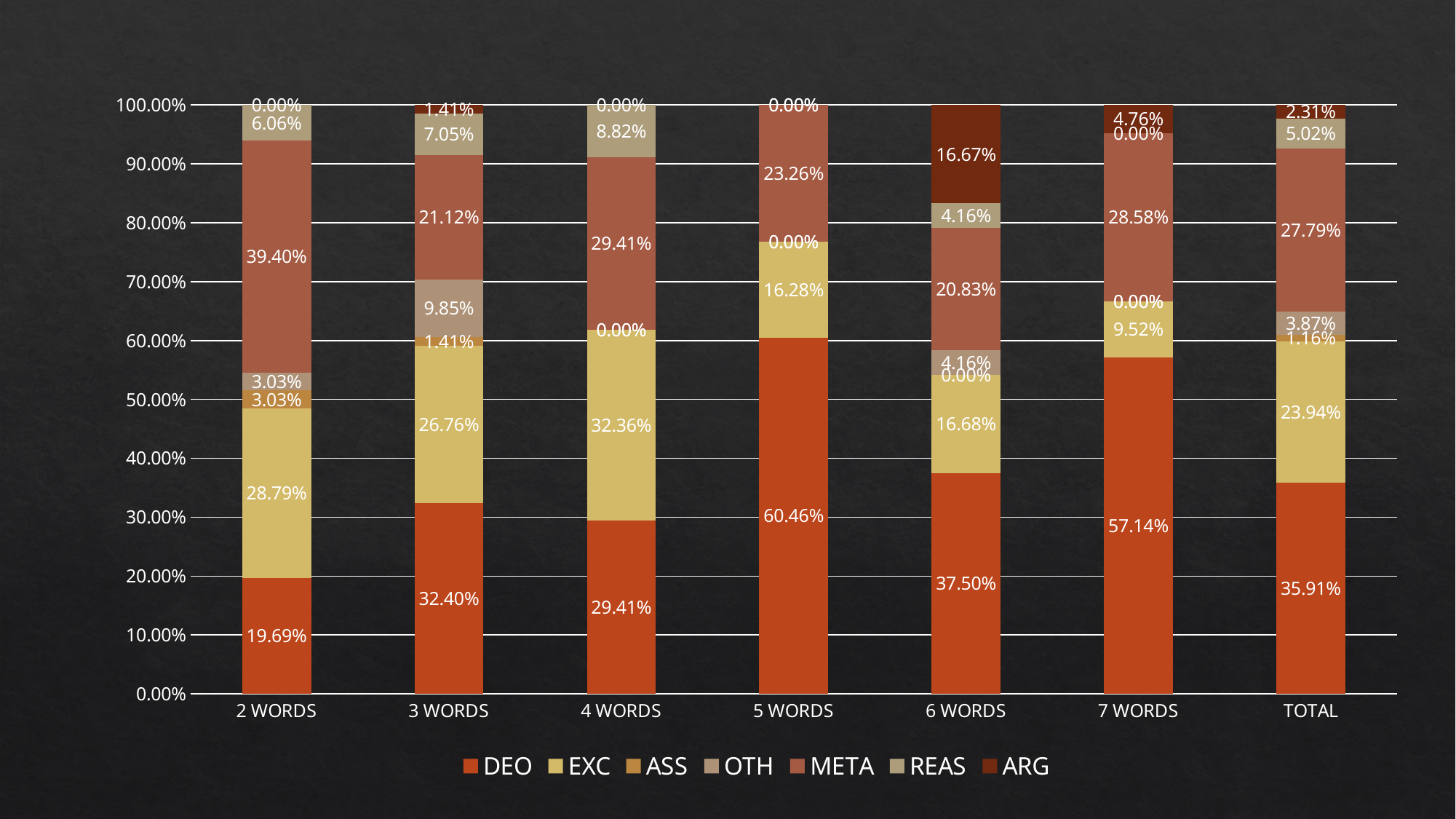
Which has the larger EXC value, 3 WORDS or 4 WORDS? 4 WORDS What is the ARG value for 6 WORDS? 16.67% How many series does the legend list? 7 Which category has the highest DEO value? 5 WORDS What is the EXC value for TOTAL? 23.94% Is the DEO value for 6 WORDS greater or less than 30.00%? greater How many categories are shown on the x axis? 7 Which category has the lowest DEO value? 2 WORDS What is the META value for 2 WORDS? 39.40% What is the DEO value for 5 WORDS? 60.46% What is the difference between the DEO value for 7 WORDS and the DEO value for 2 WORDS? 37.45% What is the REAS value for 4 WORDS? 8.82%